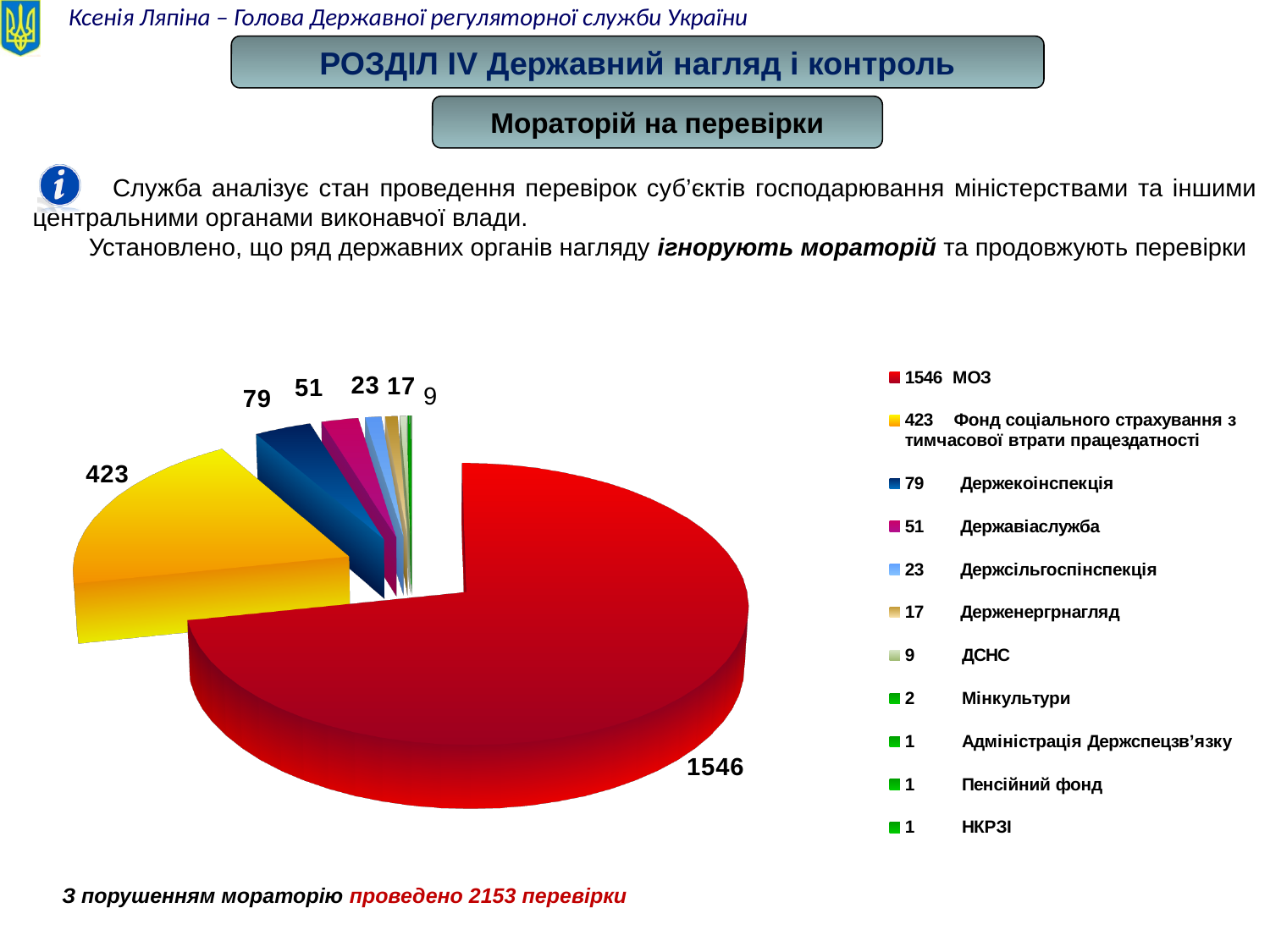
Which category has the largest slice in the pie chart? МОЗ What is the difference between the values for МОЗ and Фонд соціального страхування з тимчасової втрати працездатності? 1123 What is the total number of inspections stated on the slide as conducted in violation of the moratorium? 2153 What is the value for Держекоінспекція in the pie chart? 79 What is the value for МОЗ in the pie chart? 1546 What colour is the slice for МОЗ in the pie chart? Red How many categories does the legend of the pie chart list? 11 What is the difference between the values for Державіаслужба and Держенергнагляд? 34 What is the value for ДСНС in the pie chart? 9 What kind of chart is shown on the slide? Pie chart What is the value for Держсільгоспінспекція in the pie chart? 23 Which is larger, the value for Держекоінспекція or the value for Державіаслужба? Держекоінспекція